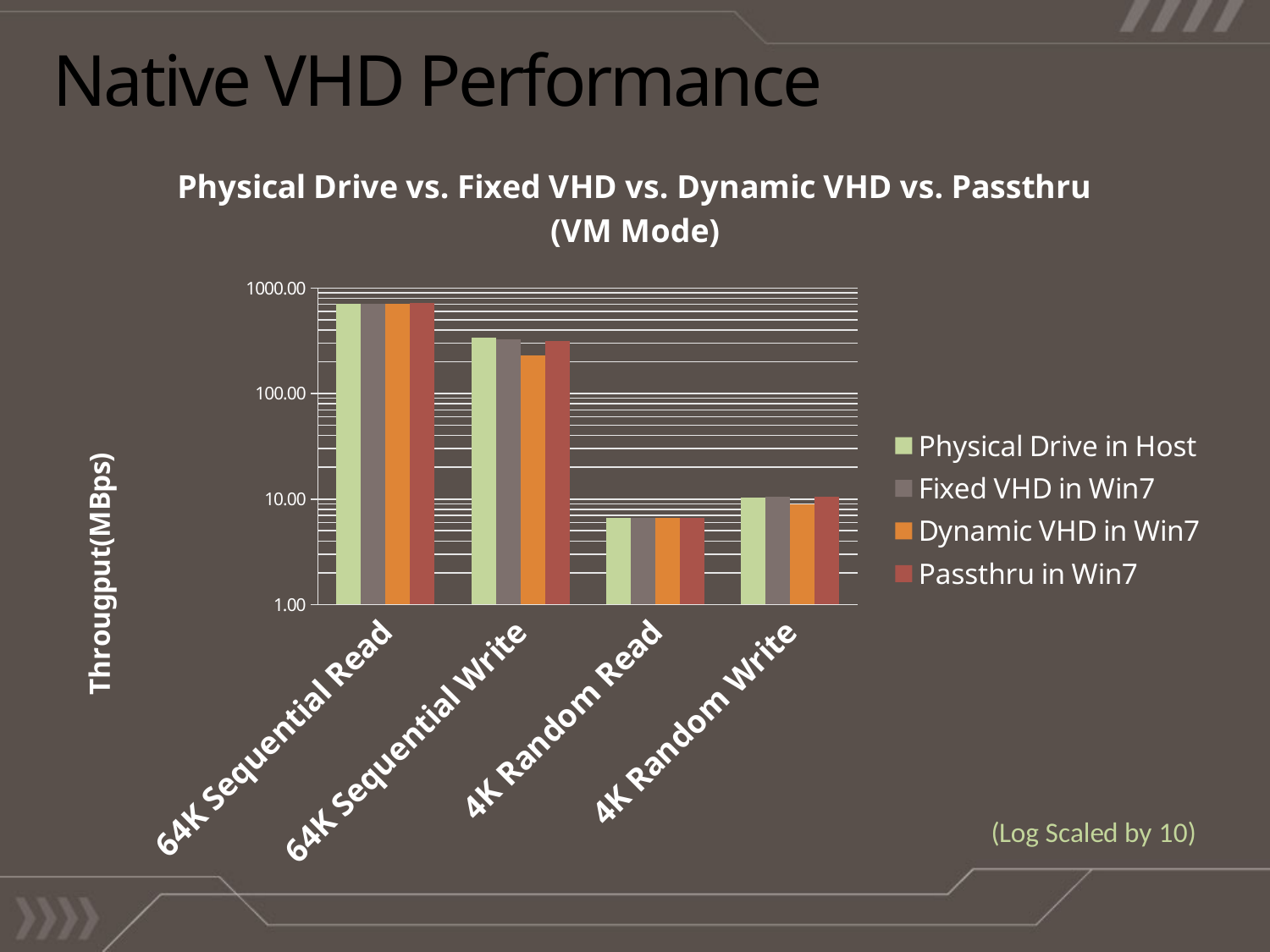
Is the value for Physical Drive in Host at 64K Sequential Read greater or less than 100.00? greater How many series does the chart's legend list? 4 Is the value for Passthru in Win7 at 4K Random Read greater or less than 10.00? less How many categories are shown on the x axis of the chart? 4 Is the value for Fixed VHD in Win7 at 64K Sequential Read greater or less than 1000.00? less What kind of chart is shown on the slide? bar chart For 64K Sequential Write, which series has the lowest value? Dynamic VHD in Win7 For Physical Drive in Host, which category has the lowest value? 4K Random Read What is the label of the chart's vertical axis? Througput(MBps) For 64K Sequential Write, which is larger: Fixed VHD in Win7 or Dynamic VHD in Win7? Fixed VHD in Win7 For Physical Drive in Host, which category has the highest value? 64K Sequential Read